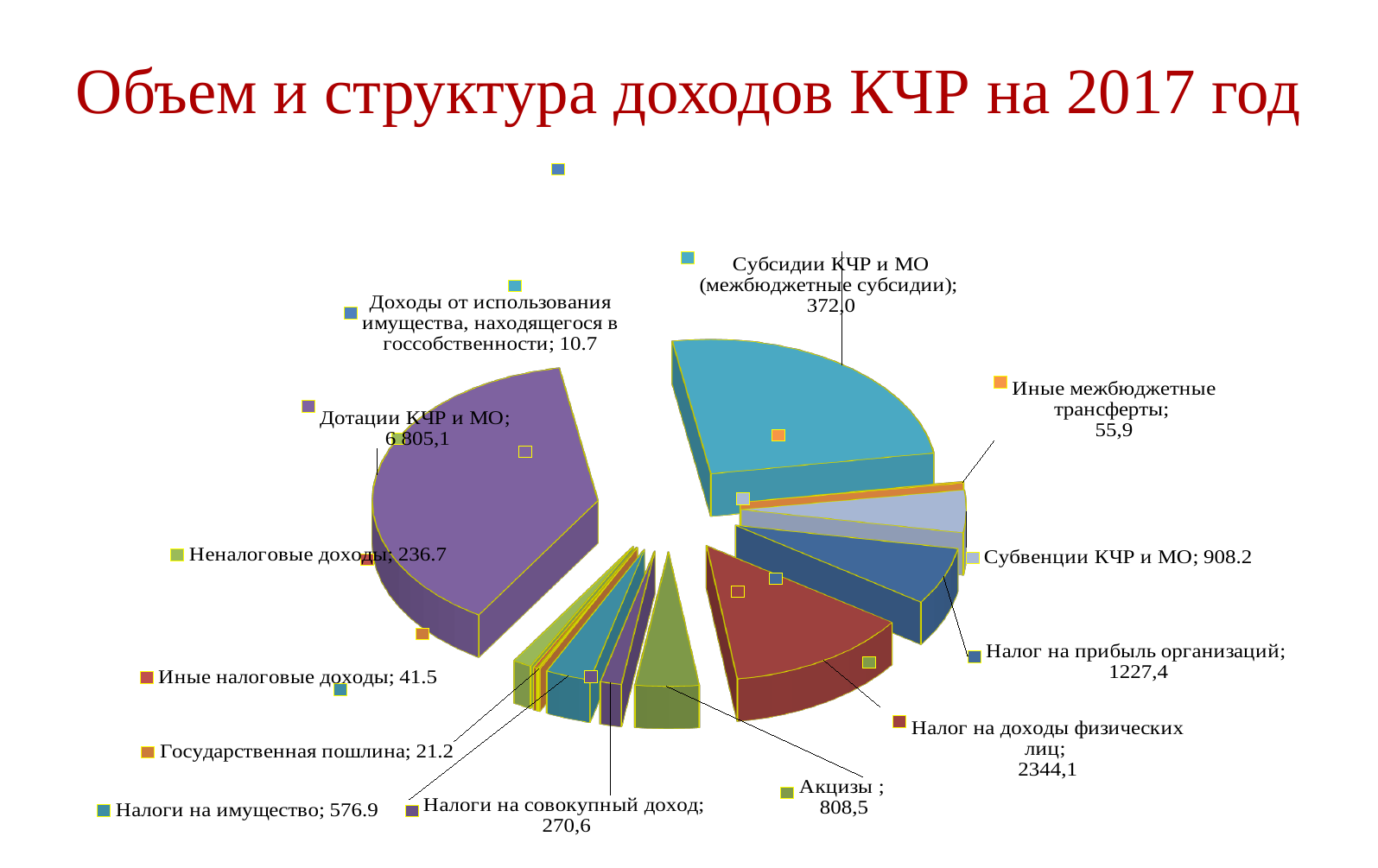
How many categories (slices) are labelled in the pie chart? 13 What is the value for Государственная пошлина? 21.2 Which is larger: Субвенции КЧР и МО or Акцизы? Субвенции КЧР и МО What is the title of the chart on the slide? Объем и структура доходов КЧР на 2017 год What is the value for Субвенции КЧР и МО? 908.2 What is the value for Дотации КЧР и МО? 6 805,1 What is the value for Налог на доходы физических лиц? 2344,1 What is the difference between Налог на доходы физических лиц and Налог на прибыль организаций? 1116,7 What type of chart is shown on the slide? Pie chart What is the difference between Субсидии КЧР и МО (межбюджетные субсидии) and Иные межбюджетные трансферты? 316,1 Which category has the largest value in the pie chart? Дотации КЧР и МО Which category has the smallest value in the pie chart? Доходы от использования имущества, находящегося в госсобственности